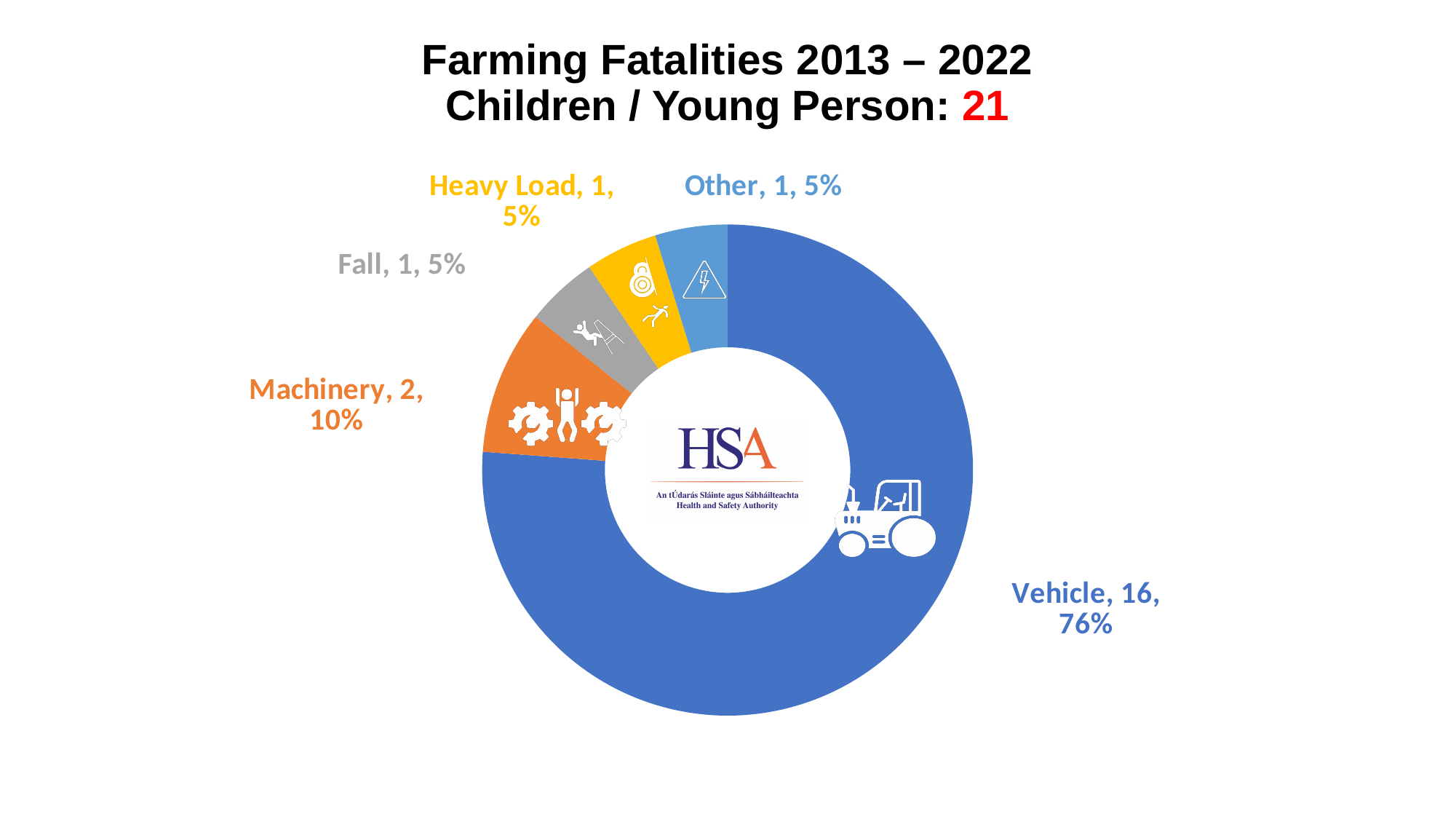
Which is larger, the number of fatalities for Machinery or for Fall? Machinery How many farming fatalities among children / young persons were attributed to Vehicle? 16 What percentage of fatalities is attributed to Machinery? 10% What kind of chart is shown on the slide? Pie chart (doughnut) How many categories are shown in the pie chart? 5 Which category accounts for the largest number of fatalities? Vehicle How many fatalities are shown for Machinery? 2 What share of fatalities is attributed to Heavy Load? 5% What is the difference between the Vehicle and Machinery fatality counts? 14 What colour is the Fall slice of the pie chart? Grey What share of the pie does the Vehicle slice represent? 76% What is the total number of children / young person fatalities stated in the chart title? 21